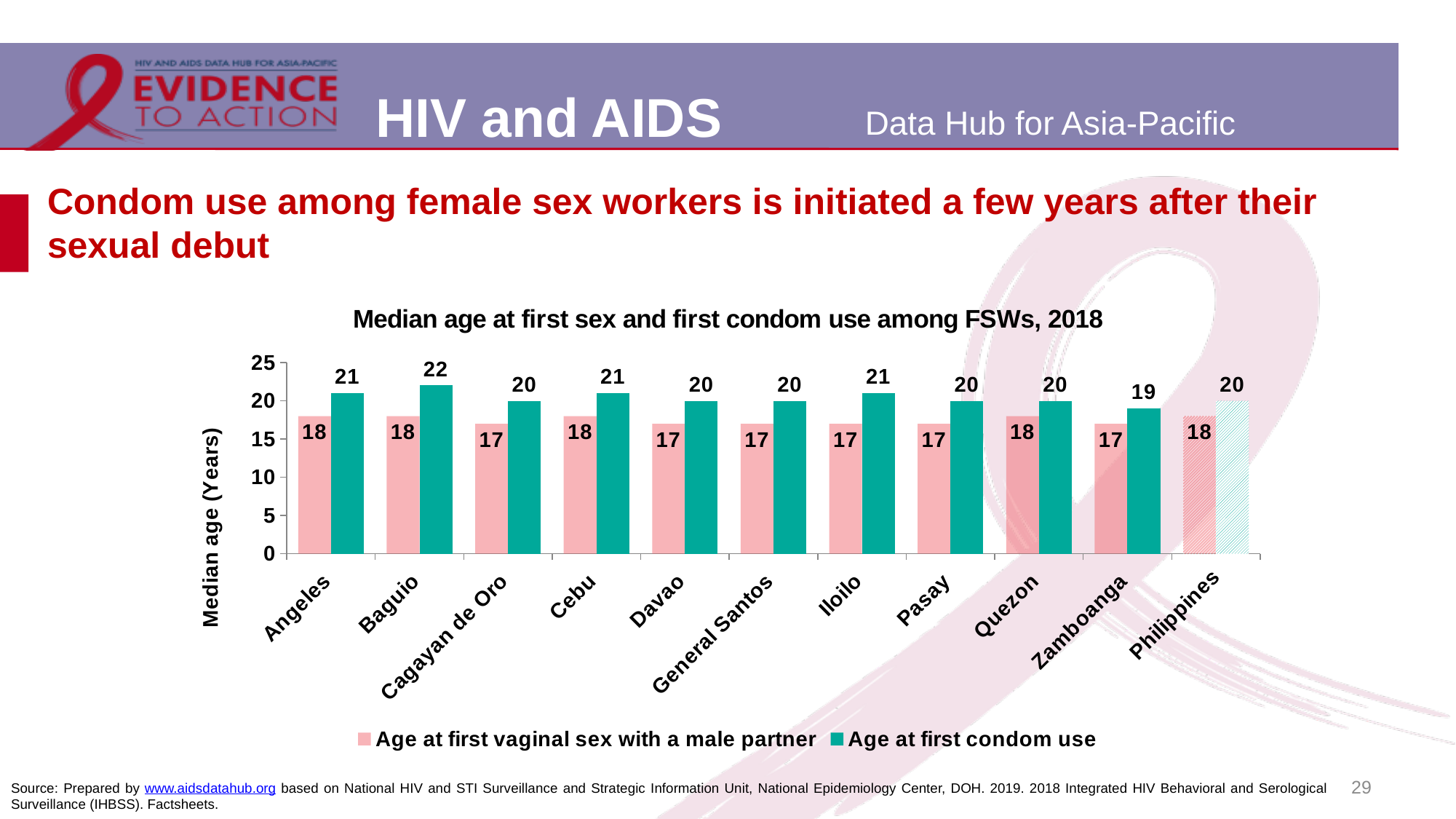
What is the median age at first condom use for the Philippines overall? 20 Which city has the highest median age at first condom use? Baguio What is the median age at first vaginal sex with a male partner in Cagayan de Oro? 17 How many series does the legend list? 2 Which city has the lowest median age at first condom use? Zamboanga What is the difference between the median age at first condom use and the median age at first vaginal sex in Baguio? 4 Which is larger in Iloilo: the median age at first condom use or the median age at first vaginal sex? Age at first condom use What is the title of the chart? Median age at first sex and first condom use among FSWs, 2018 How many categories (cities plus the national figure) are shown on the x axis? 11 What type of chart is shown on the slide? Bar chart What is the difference between the median age at first condom use and the median age at first vaginal sex in Zamboanga? 2 What is the median age at first condom use in Baguio? 22